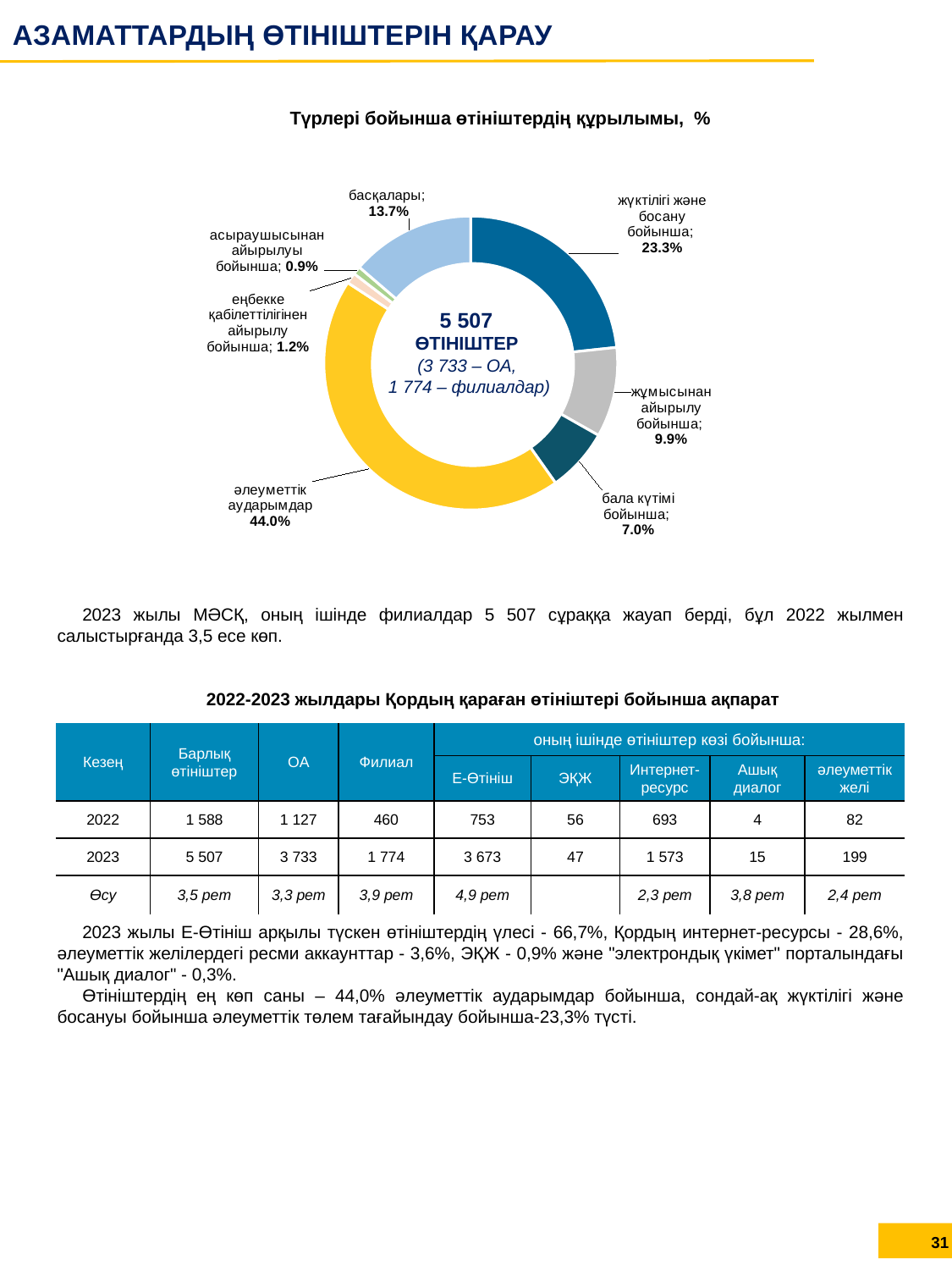
What share of the chart does "әлеуметтік аударымдар" account for? 44.0% What percentage is shown for "бала күтімі бойынша"? 7.0% How many categories are shown in the chart? 7 What share is labelled for "басқалары"? 13.7% What is the value for "жұмысынан айырылу бойынша"? 9.9% What total number of applications is shown in the centre of the chart? 5 507 Which category has the largest share of the chart? әлеуметтік аударымдар What is the difference in percentage points between "әлеуметтік аударымдар" and "жүктілігі және босану бойынша"? 20.7 Which category has the smallest share of the chart? асыраушысынан айырылуы бойынша Which is larger: the share for "басқалары" or the share for "жұмысынан айырылу бойынша"? басқалары What is the value shown for "жүктілігі және босану бойынша"? 23.3% What kind of chart is shown on the slide? Pie (doughnut) chart